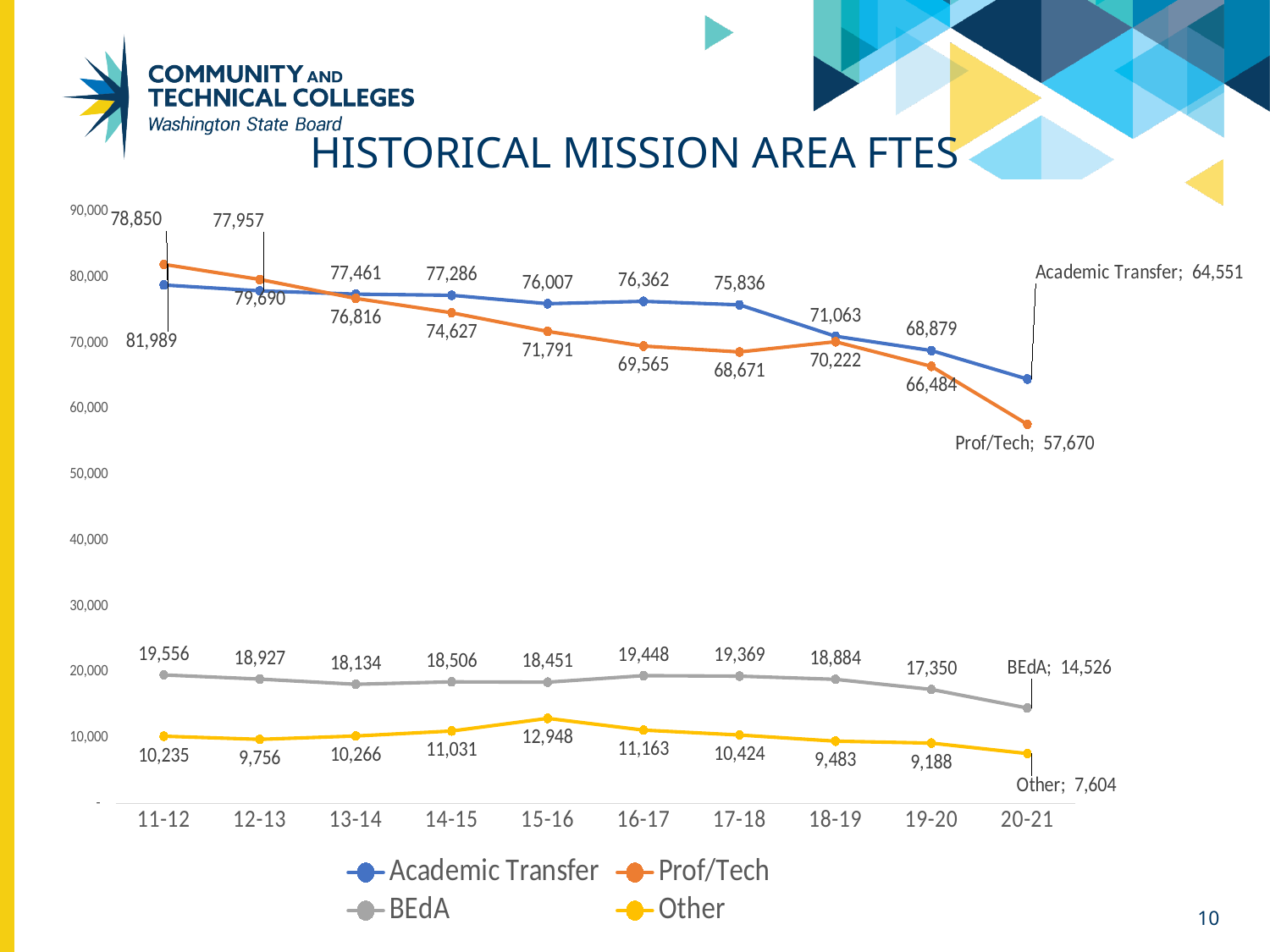
What is the Academic Transfer value for 20-21? 64,551 Does the Academic Transfer series generally rise or fall from 11-12 to 20-21? Fall How many years are shown on the x axis? 10 What is the BEdA value for 15-16? 18,451 What is the Other value for 15-16? 12,948 How many series does the legend list? 4 In which year is the Other series at its highest? 15-16 In which year is the Prof/Tech series at its lowest? 20-21 In 11-12, which is larger: Academic Transfer or Prof/Tech? Prof/Tech What is the Prof/Tech value for 11-12? 81,989 What kind of chart is shown on the slide? Line chart By how much did Academic Transfer fall from 11-12 to 20-21? 14,299